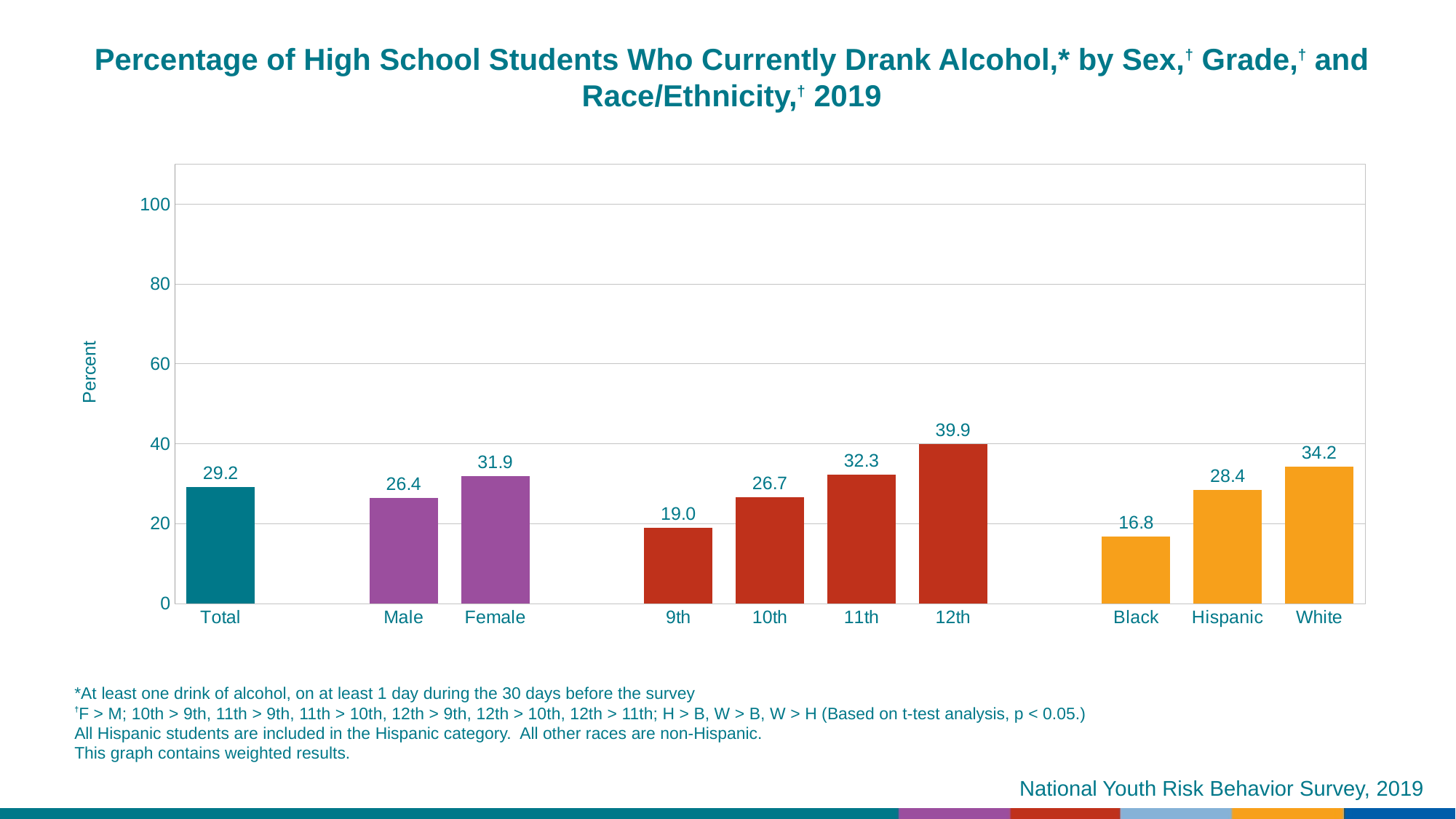
What is the value for 12th grade? 39.9 Which category has the lowest value? Black What is the difference between the values for White and Hispanic? 5.8 What is the value for Black students? 16.8 What is the difference between the values for Female and Male? 5.5 Which is larger, the value for 11th grade or the value for White? White What kind of chart is shown? bar chart Do the values rise or fall from 9th grade to 12th grade? rise What is the value for Female? 31.9 What is the value for Total? 29.2 Which category has the highest value? 12th How many bars are plotted on the chart? 10